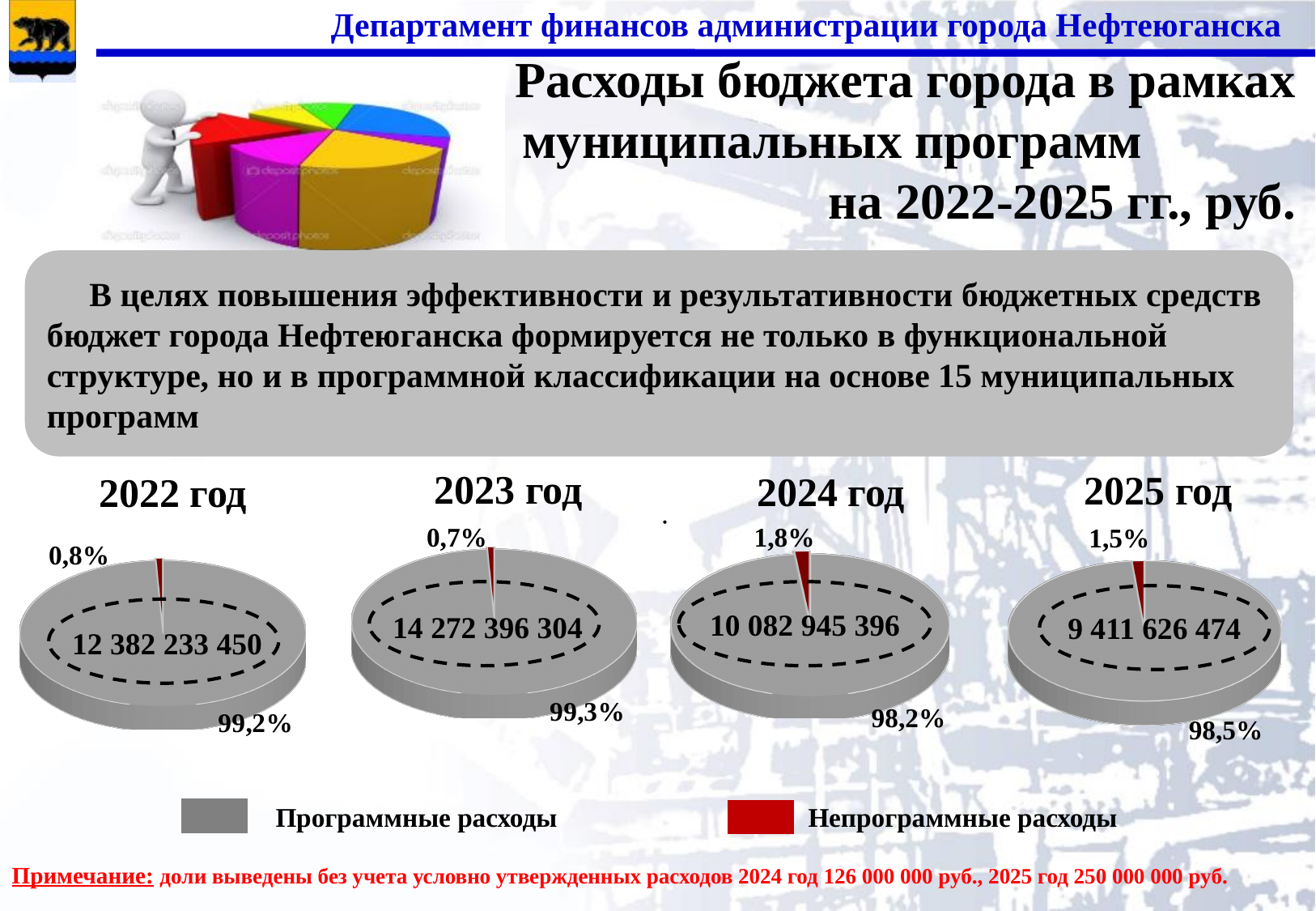
In the 2023 год pie chart, what share is shown for Программные расходы? 99,3% Across the four pie charts, which year shows the lowest share of Непрограммные расходы? 2023 год What type of chart is used to show the expenses for each year? Pie chart In the 2025 год pie chart, what share is shown for Программные расходы? 98,5% What is the difference between the Непрограммные расходы share in the 2024 год chart and in the 2023 год chart? 1,1% What total value is printed in the centre of the 2025 год pie chart? 9 411 626 474 Across the four pie charts, which year shows the highest share of Непрограммные расходы? 2024 год Which is larger: the Программные расходы share in the 2022 год chart or in the 2025 год chart? 2022 год In the 2024 год pie chart, what share is shown for Непрограммные расходы? 1,8% How many series does the legend list? 2 What total value is printed in the centre of the 2023 год pie chart? 14 272 396 304 In the 2022 год pie chart, what share is shown for Непрограммные расходы? 0,8%